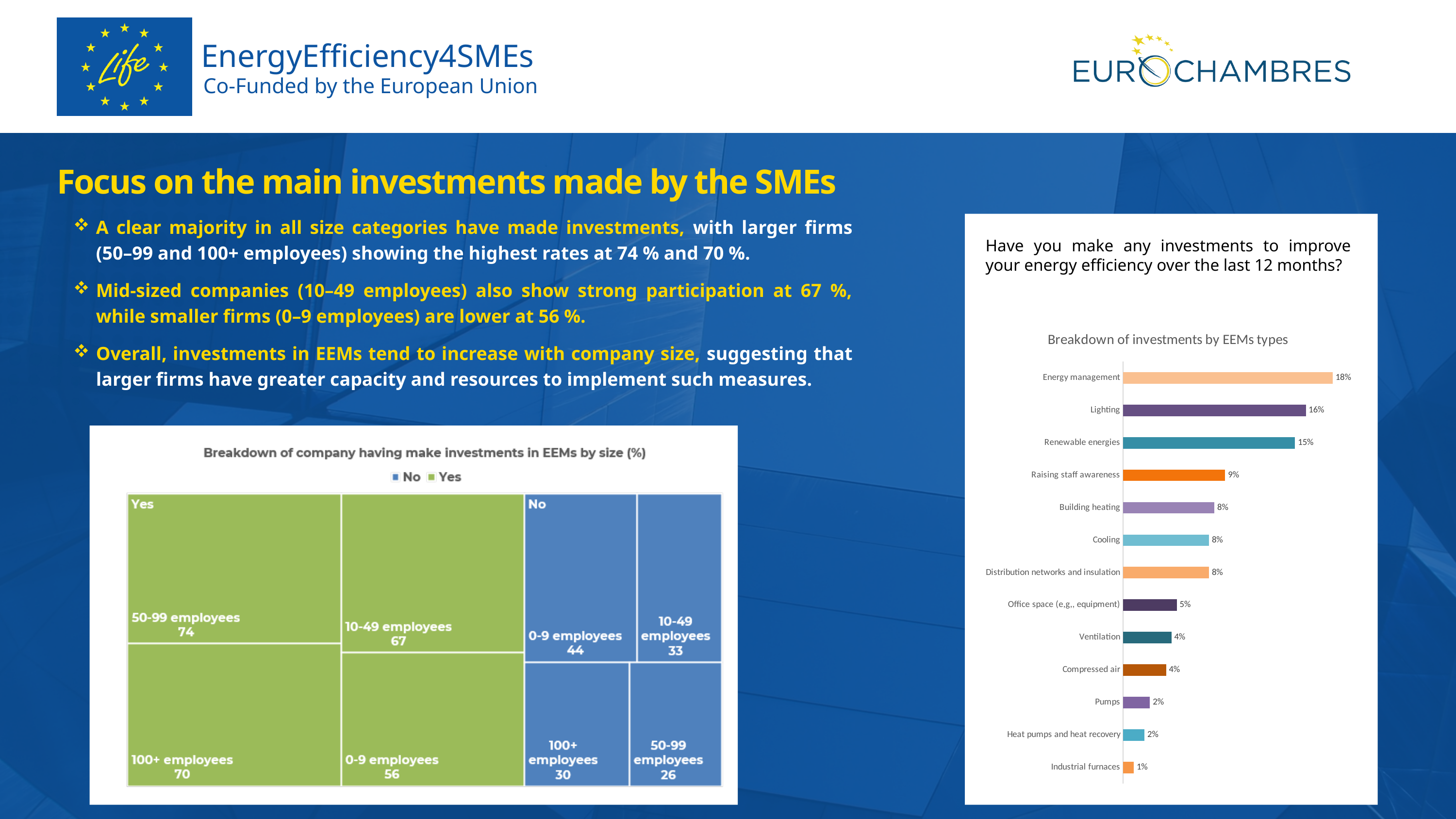
In the 'Breakdown of investments by EEMs types' chart, what is the value for Renewable energies? 15% What kind of chart is the 'Breakdown of investments by EEMs types' chart? Bar chart How many series does the legend list in the 'Breakdown of company having make investments in EEMs by size (%)' chart? 2 How many categories are shown in the 'Breakdown of investments by EEMs types' chart? 13 In the 'Breakdown of investments by EEMs types' chart, what is the difference between Lighting and Raising staff awareness? 7% In the 'Breakdown of investments by EEMs types' chart, which category has the lowest value? Industrial furnaces In the 'Breakdown of company having make investments in EEMs by size (%)' chart, what is the No value for 0-9 employees? 44 In the 'Breakdown of investments by EEMs types' chart, which is larger: Office space (e.g., equipment) or Ventilation? Office space (e.g., equipment) In the 'Breakdown of company having make investments in EEMs by size (%)' chart, what is the Yes value for 50-99 employees? 74 In the 'Breakdown of company having make investments in EEMs by size (%)' chart, what is the difference between the Yes values for 100+ employees and 0-9 employees? 14 In the 'Breakdown of investments by EEMs types' chart, which category has the highest value? Energy management In the 'Breakdown of investments by EEMs types' chart, what is the value for Energy management? 18%